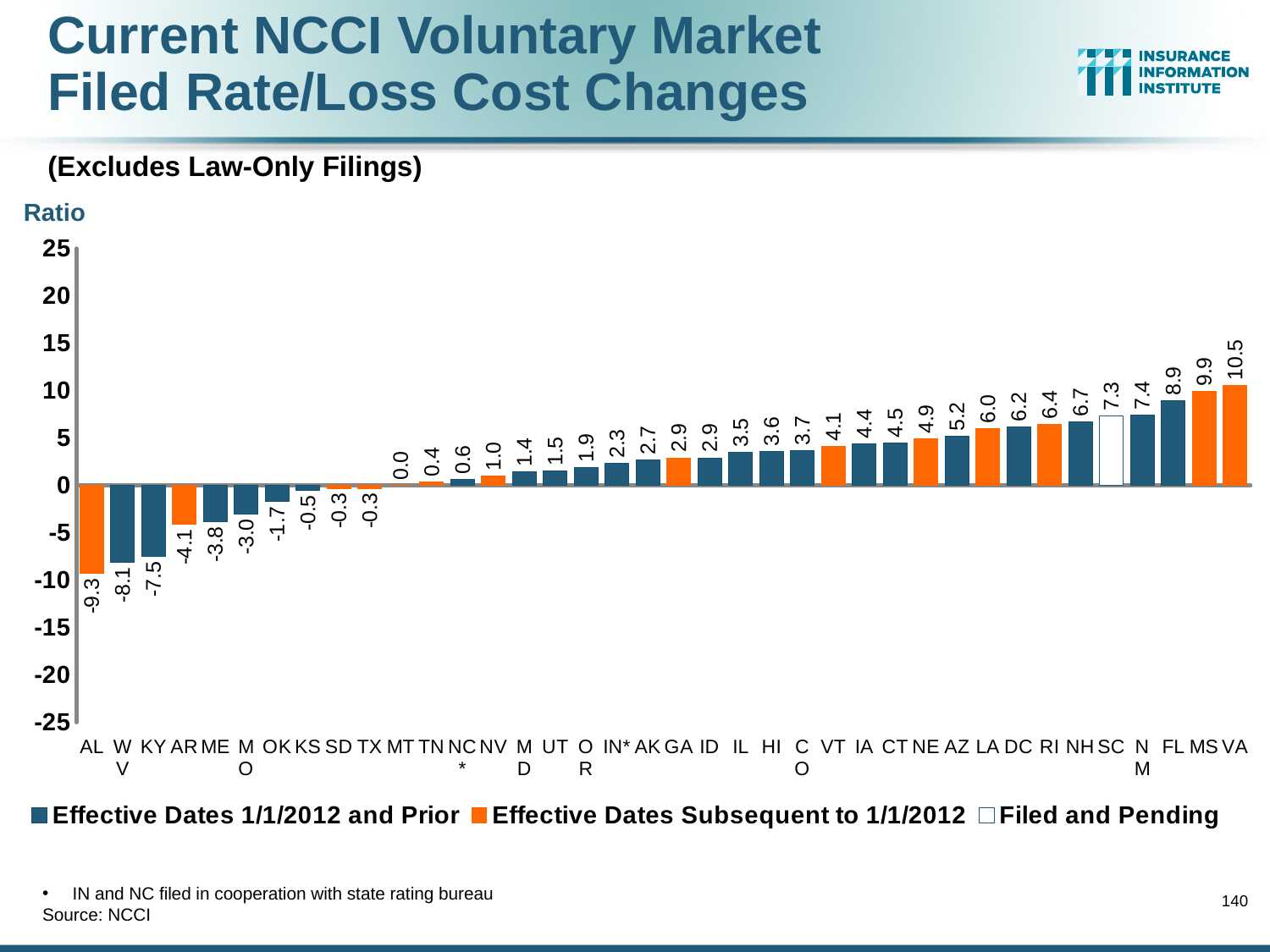
What is the value for VA? 10.5 Which state is shown as Filed and Pending? SC What is the difference between the values for VA and AL? 19.8 Which state has the lowest value? AL Which has the larger value, FL or MS? MS How many series does the legend list? 3 Which state has the highest value? VA What kind of chart is shown? Bar chart How many states are shown on the chart? 38 Do the values rise or fall from left to right along the x axis? Rise What is the value for AL? -9.3 What is the value for SC? 7.3